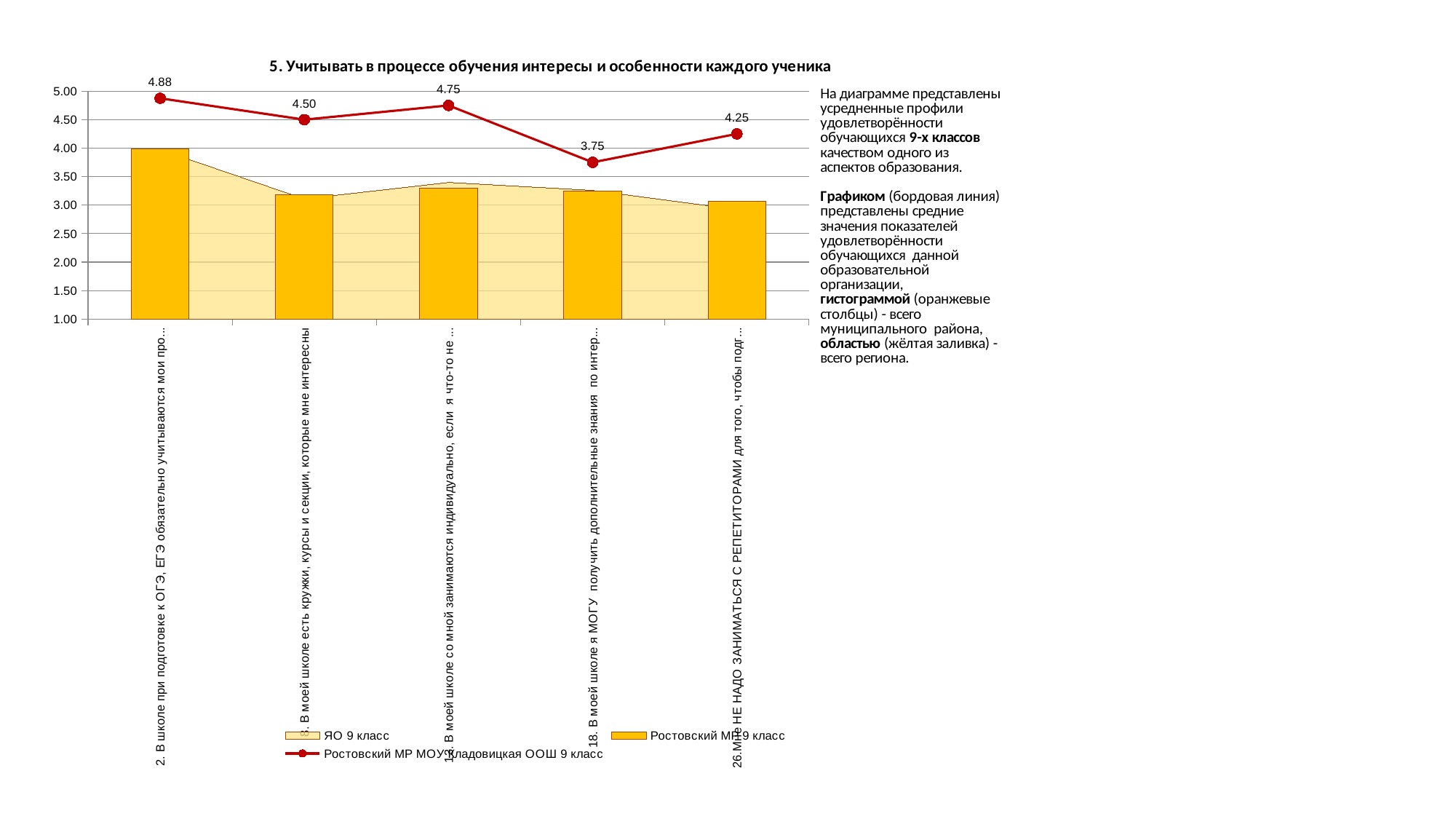
By how much does the line value for item 13 (4.75) exceed the line value for item 8 (4.50)? 0.25 Is the Ростовский МР 9 класс bar for item 2 greater or less than 3.50? greater How many series does the chart legend list? 3 For which item does the Ростовский МР МОУ Кладовицкая ООШ 9 класс line reach its highest value? 2. В школе при подготовке к ОГЭ, ЕГЭ обязательно учитываются мои про... What is the value of the Ростовский МР МОУ Кладовицкая ООШ 9 класс line for item 8 (В моей школе есть кружки, курсы и секции, которые мне интересны)? 4.50 What is the value of the Ростовский МР МОУ Кладовицкая ООШ 9 класс line for item 26 (МНЕ НЕ НАДО ЗАНИМАТЬСЯ С РЕПЕТИТОРАМИ...)? 4.25 Which has the larger value on the Ростовский МР МОУ Кладовицкая ООШ 9 класс line: item 13 or item 26? Item 13 What is the value of the Ростовский МР МОУ Кладовицкая ООШ 9 класс line for item 18 (В моей школе я МОГУ получить дополнительные знания...)? 3.75 For which item does the Ростовский МР МОУ Кладовицкая ООШ 9 класс line have its lowest value? 18. В моей школе я МОГУ получить дополнительные знания по интер... Is the Ростовский МР 9 класс bar for item 8 greater or less than 3.50? less How many items (categories) are shown on the x axis of the chart? 5 What is the difference between the highest (4.88) and lowest (3.75) values of the Ростовский МР МОУ Кладовицкая ООШ 9 класс line? 1.13